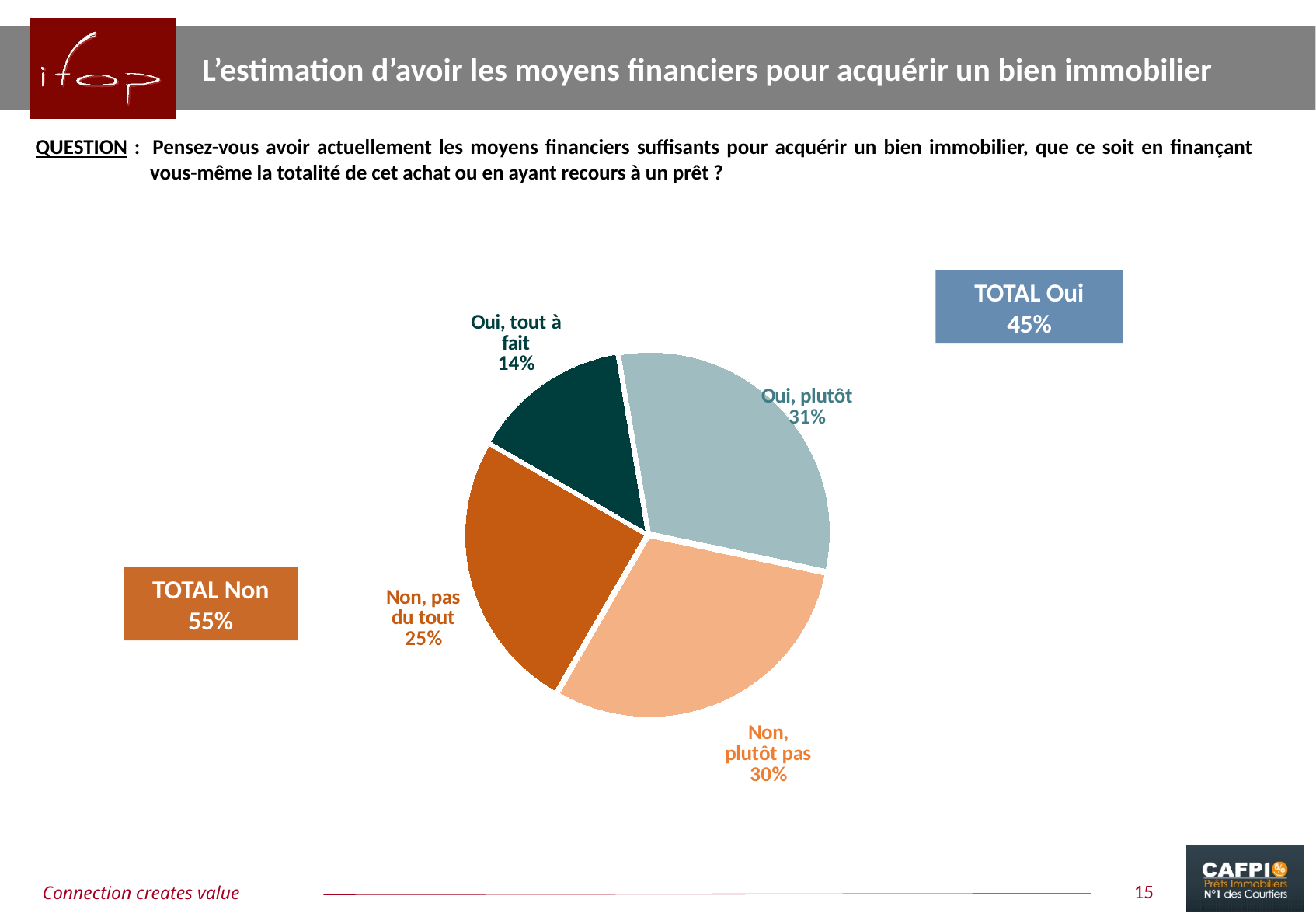
What is the difference in percentage points between "Oui, plutôt" and "Oui, tout à fait"? 17 What percentage of respondents answered "Non, pas du tout"? 25% Which is larger: the share for "Non, plutôt pas" or the share for "Non, pas du tout"? Non, plutôt pas What percentage of respondents answered "Non, plutôt pas"? 30% What percentage of respondents answered "Oui, plutôt"? 31% How many slices does the pie chart have? 4 Which response category has the smallest share of the pie? Oui, tout à fait What is the value shown in the "TOTAL Non" box? 55% What is the value shown in the "TOTAL Oui" box? 45% Which response category has the largest share of the pie? Oui, plutôt What type of chart is shown on the slide? pie chart What percentage of respondents answered "Oui, tout à fait"? 14%